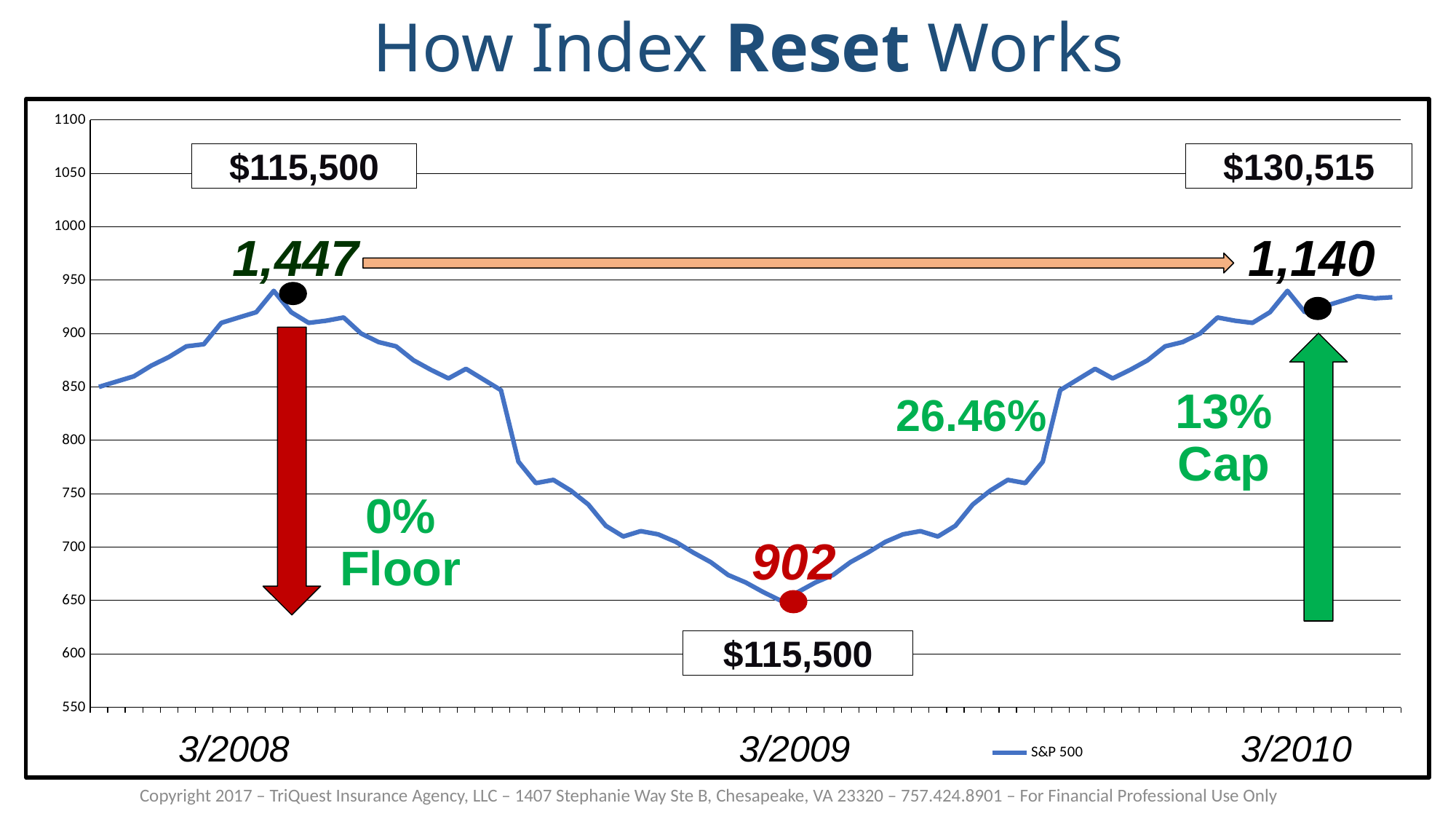
What index value is labeled at 3/2009? 902 Which of the three labeled dates has the lowest index value? 3/2009 Is the labeled index value at 3/2010 larger or smaller than the labeled value at 3/2008? smaller What is the difference between the labeled index values at 3/2008 and 3/2009? 545 Does the S&P 500 line rise or fall between 3/2009 and 3/2010? rise How many series does the legend list? 1 What series does the legend list for the chart? S&P 500 What index value is labeled at 3/2010? 1,140 What index value is labeled at 3/2008? 1,447 What dollar amount is shown in the box at 3/2010? $130,515 Which of the three labeled dates has the highest index value? 3/2008 What type of chart is shown on the slide? line chart